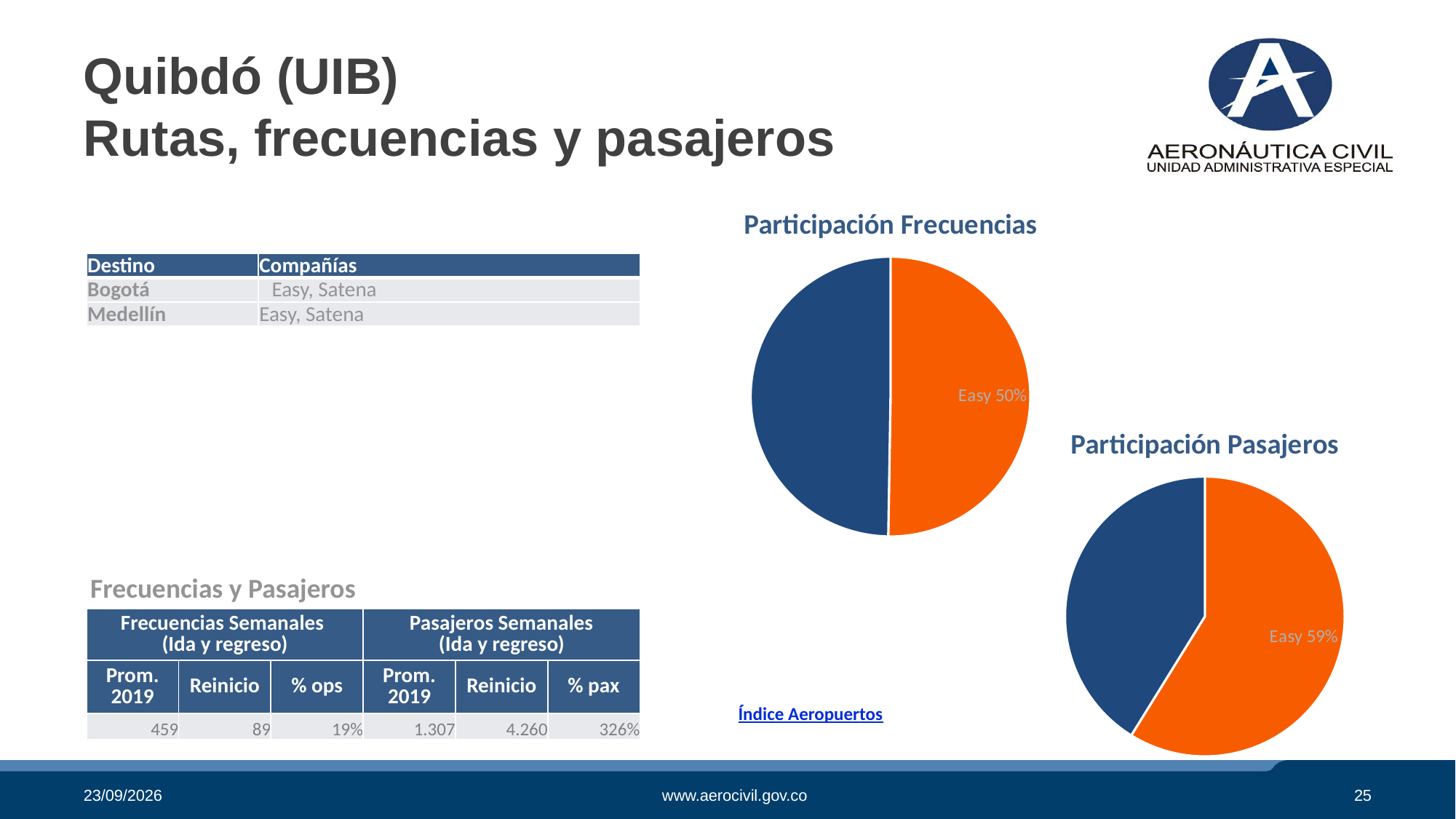
What kind of chart is the "Participación Pasajeros" chart? Pie chart In the "Participación Pasajeros" chart, is the Easy share greater or less than 50%? greater In the "Participación Pasajeros" chart, which slice is larger, the Easy slice or the other slice? Easy How many slices does the "Participación Pasajeros" pie chart have? 2 Which chart shows a larger share for Easy, "Participación Frecuencias" or "Participación Pasajeros"? Participación Pasajeros How many slices does the "Participación Frecuencias" pie chart have? 2 In the "Participación Pasajeros" chart, what share does the Easy slice have? 59% What colour is the Easy slice in the "Participación Pasajeros" chart? Orange What is the title of the upper pie chart on the slide? Participación Frecuencias By how many percentage points is the Easy share in "Participación Pasajeros" larger than in "Participación Frecuencias"? 9 In the "Participación Frecuencias" chart, what share does the Easy slice have? 50% What kind of chart is the "Participación Frecuencias" chart? Pie chart